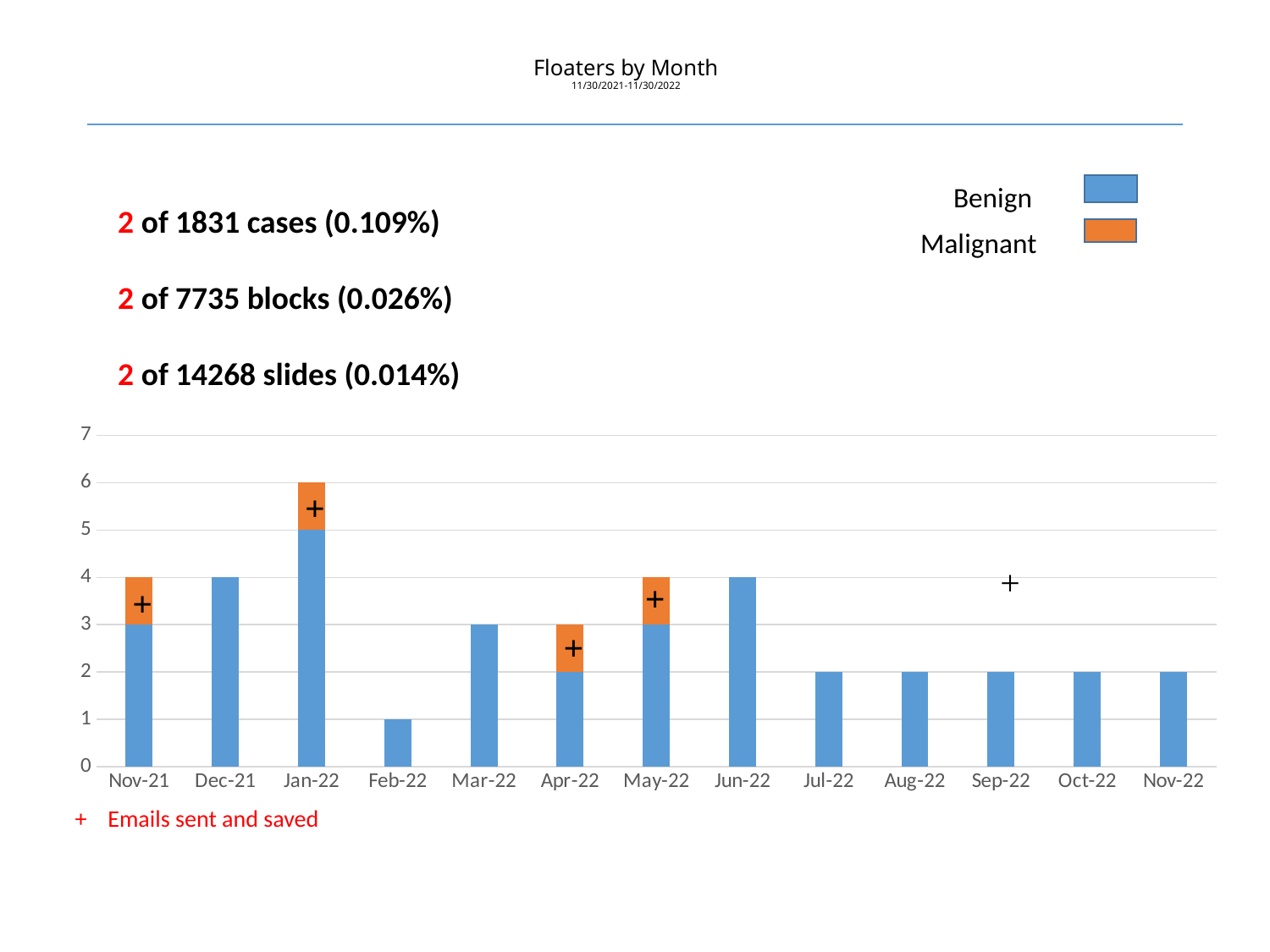
What is the total height of the stacked bar for Nov-21? 4 What is the Benign value for Jan-22? 5 Which month has the shortest bar in the chart? Feb-22 What is the difference between the total for Jan-22 and the total for Feb-22? 5 How many months are shown on the x axis of the chart? 13 What kind of chart is shown on the slide? stacked bar chart Is the bar for Jun-22 taller than the bar for Jul-22? Yes How many series does the chart legend list? 2 Which series is shown in orange in the chart legend? Malignant Which month has the tallest bar in the chart? Jan-22 What is the total height of the stacked bar for Jan-22? 6 What is the Benign value for Apr-22? 2